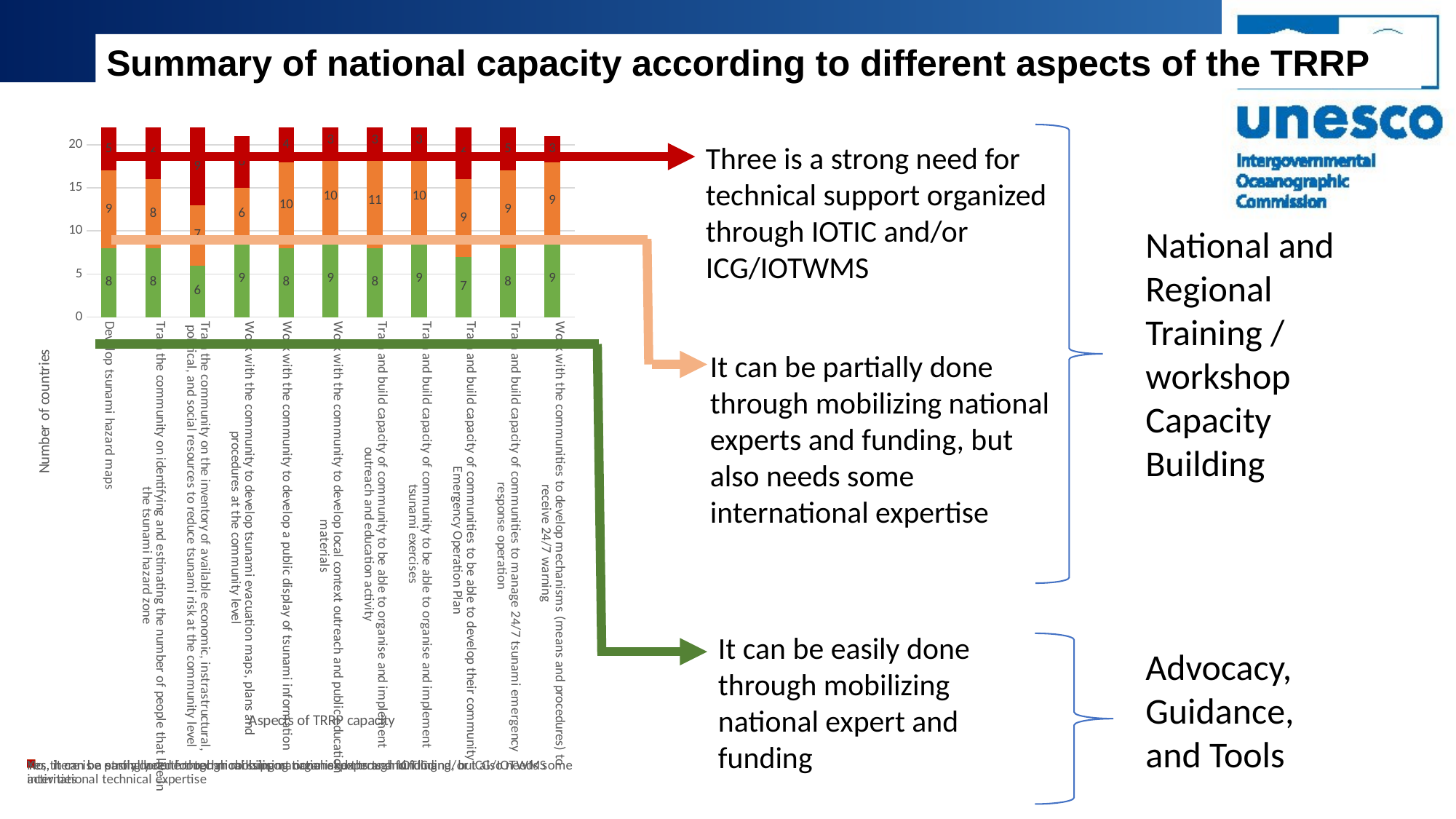
What is the value of the green (bottom) segment for 'Develop tsunami hazard maps'? 8 What is the title of the horizontal axis of the chart? Aspects of TRRP capacity What is the difference between the orange segment for 'Train and build capacity of community to be able to organise and implement outreach and education activity' (11) and the orange segment for 'Work with the community to develop tsunami evacuation maps, plans and procedures at the community level' (6)? 5 What is the title of the vertical axis of the chart? Number of countries What is the value of the orange (middle) segment for 'Work with the community to develop a public display of tsunami information'? 10 Is the total height of the bar for 'Develop tsunami hazard maps' greater or less than 20? greater How many categories (bars) are plotted along the x axis of the chart? 11 Which is larger: the green segment for 'Develop tsunami hazard maps' or the green segment for 'Train the community on the inventory of available economic, instrastructural, political, and social resources to reduce tsunami risk at the community level'? Develop tsunami hazard maps Which category has the highest value in the orange (middle) segment? Train and build capacity of community to be able to organise and implement outreach and education activity Which category has the lowest value in the green (bottom) segment? Train the community on the inventory of available economic, instrastructural, political, and social resources to reduce tsunami risk at the community level What type of chart is shown on the slide? Stacked bar chart How many stacked segments (series) make up each bar in the chart? 3